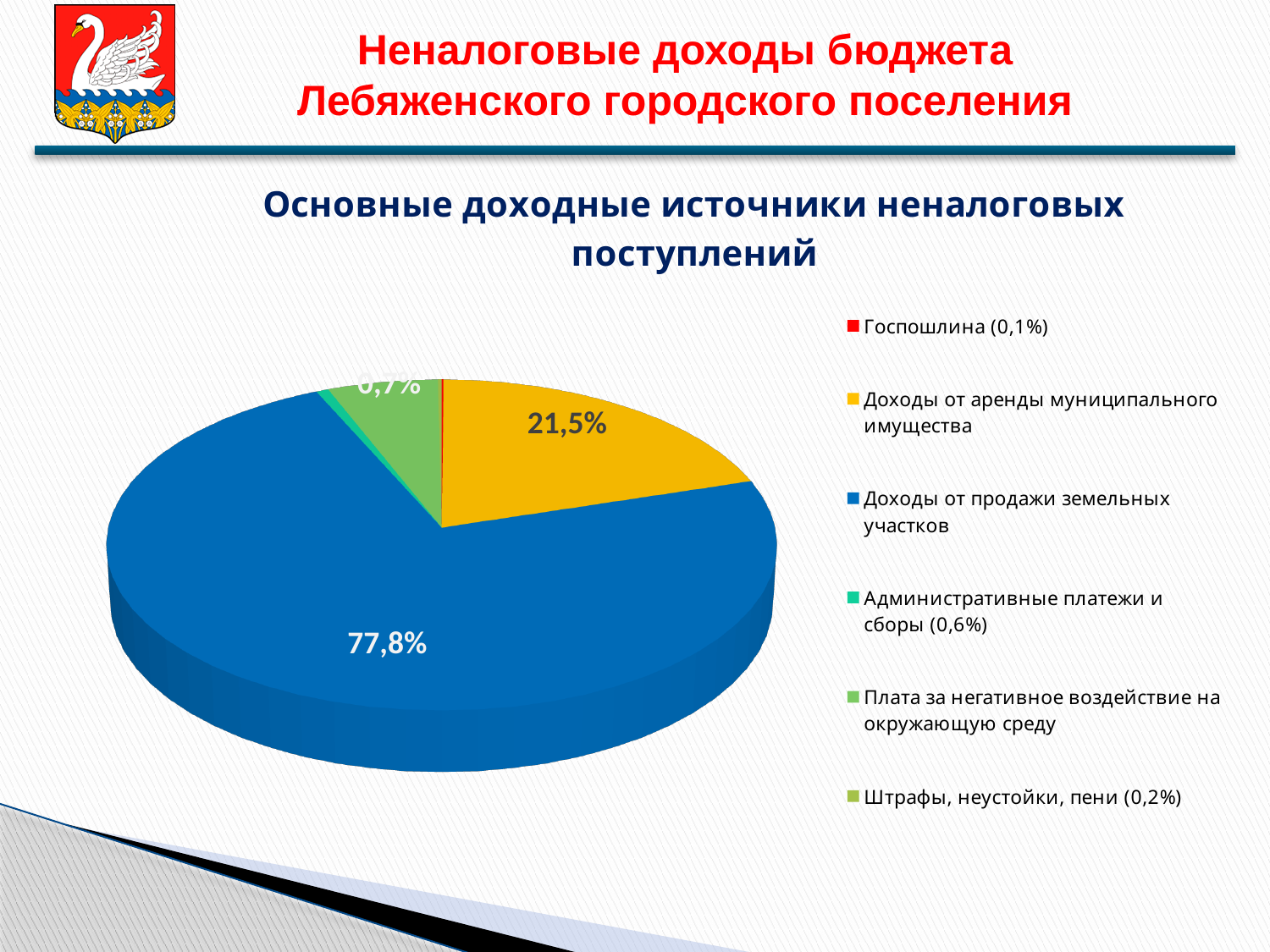
What share of the pie is 'Доходы от аренды муниципального имущества'? 21,5% What share of the pie is 'Доходы от продажи земельных участков'? 77,8% What is the difference between the shares of 'Доходы от продажи земельных участков' and 'Доходы от аренды муниципального имущества'? 56,3% What percentage is given in the legend for 'Административные платежи и сборы'? 0,6% What percentage is given in the legend for 'Штрафы, неустойки, пени'? 0,2% What is the chart's title? Основные доходные источники неналоговых поступлений What percentage is given in the legend for 'Госпошлина'? 0,1% What kind of chart is shown on the slide? pie chart How many categories does the legend list? 6 Which category has the smallest share? Госпошлина Which category has the largest share of the pie? Доходы от продажи земельных участков